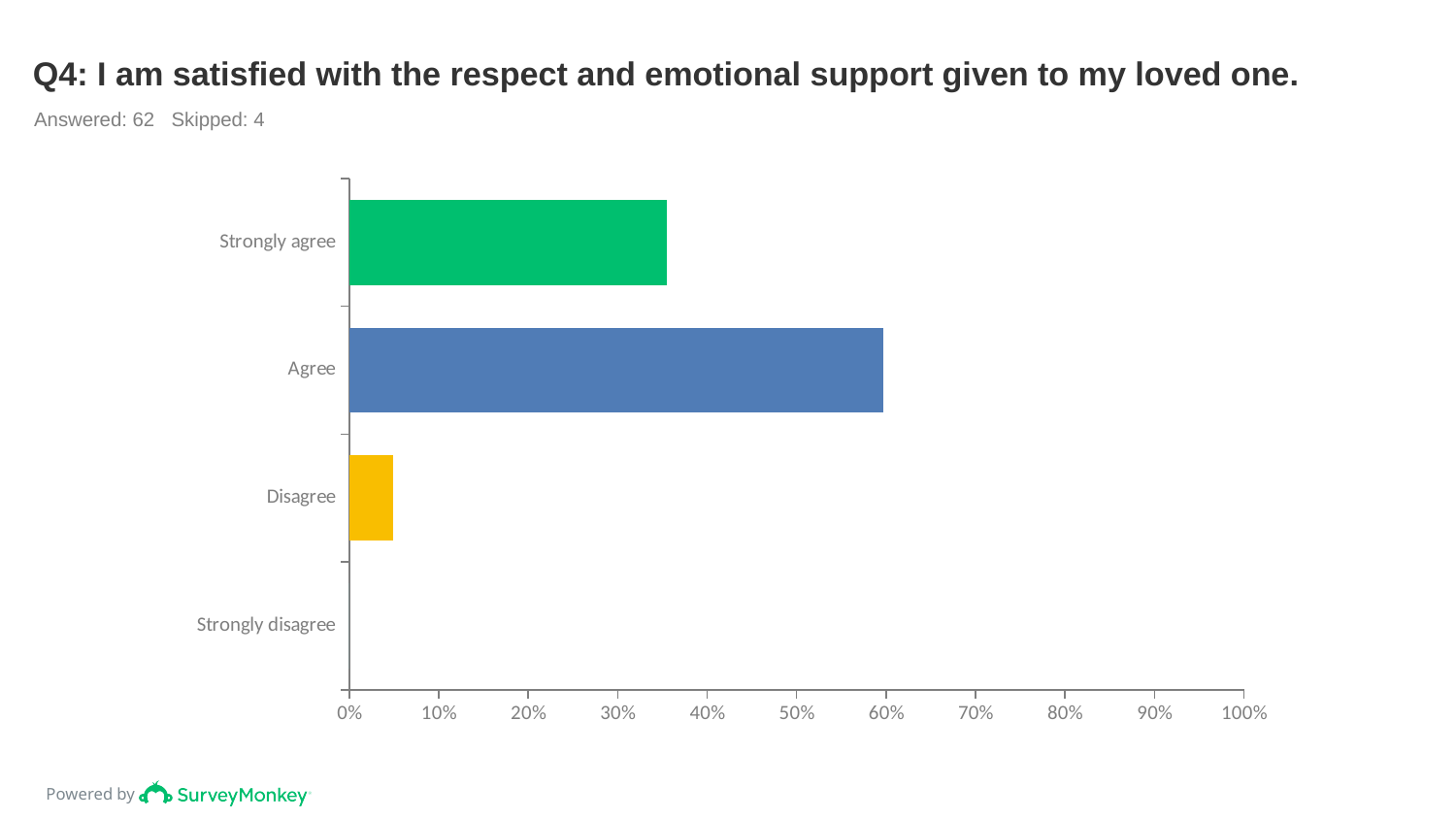
Is the value for Disagree greater or less than 10%? less Is the value for Strongly agree greater or less than 40%? less Which is larger, the value for Agree or the value for Strongly agree? Agree How many respondents answered this question according to the slide? 62 What kind of chart is shown on the slide? bar chart Which is larger, the value for Strongly agree or the value for Disagree? Strongly agree Is the value for Agree greater or less than 50%? greater How many response categories are shown in the chart? 4 Which response category has the lowest value? Strongly disagree What colour is the bar for Agree? blue Which response category has the highest value? Agree